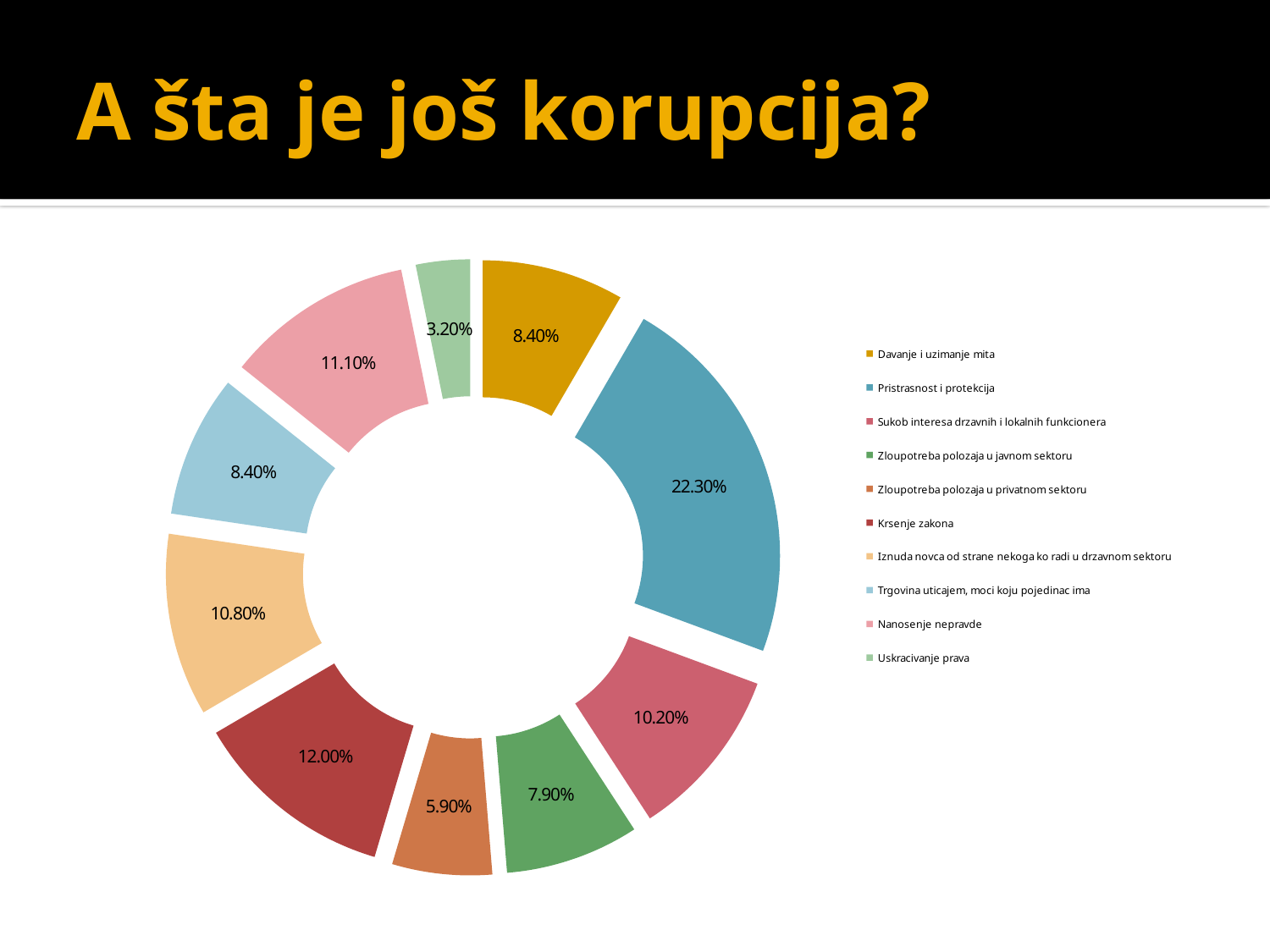
What kind of chart is shown on the slide? Doughnut (pie) chart What is the value for Nanosenje nepravde? 11.10% What is the difference between the values for Pristrasnost i protekcija and Krsenje zakona? 10.30% Which category has the largest share? Pristrasnost i protekcija What is the value for Pristrasnost i protekcija? 22.30% How many categories does the chart show? 10 Which category has the smallest share? Uskracivanje prava Which is larger, Sukob interesa drzavnih i lokalnih funkcionera or Zloupotreba polozaja u javnom sektoru? Sukob interesa drzavnih i lokalnih funkcionera What is the value for Zloupotreba polozaja u privatnom sektoru? 5.90% What is the value for Iznuda novca od strane nekoga ko radi u drzavnom sektoru? 10.80% What is the title of the slide? A šta je još korupcija? What is the value for Krsenje zakona? 12.00%